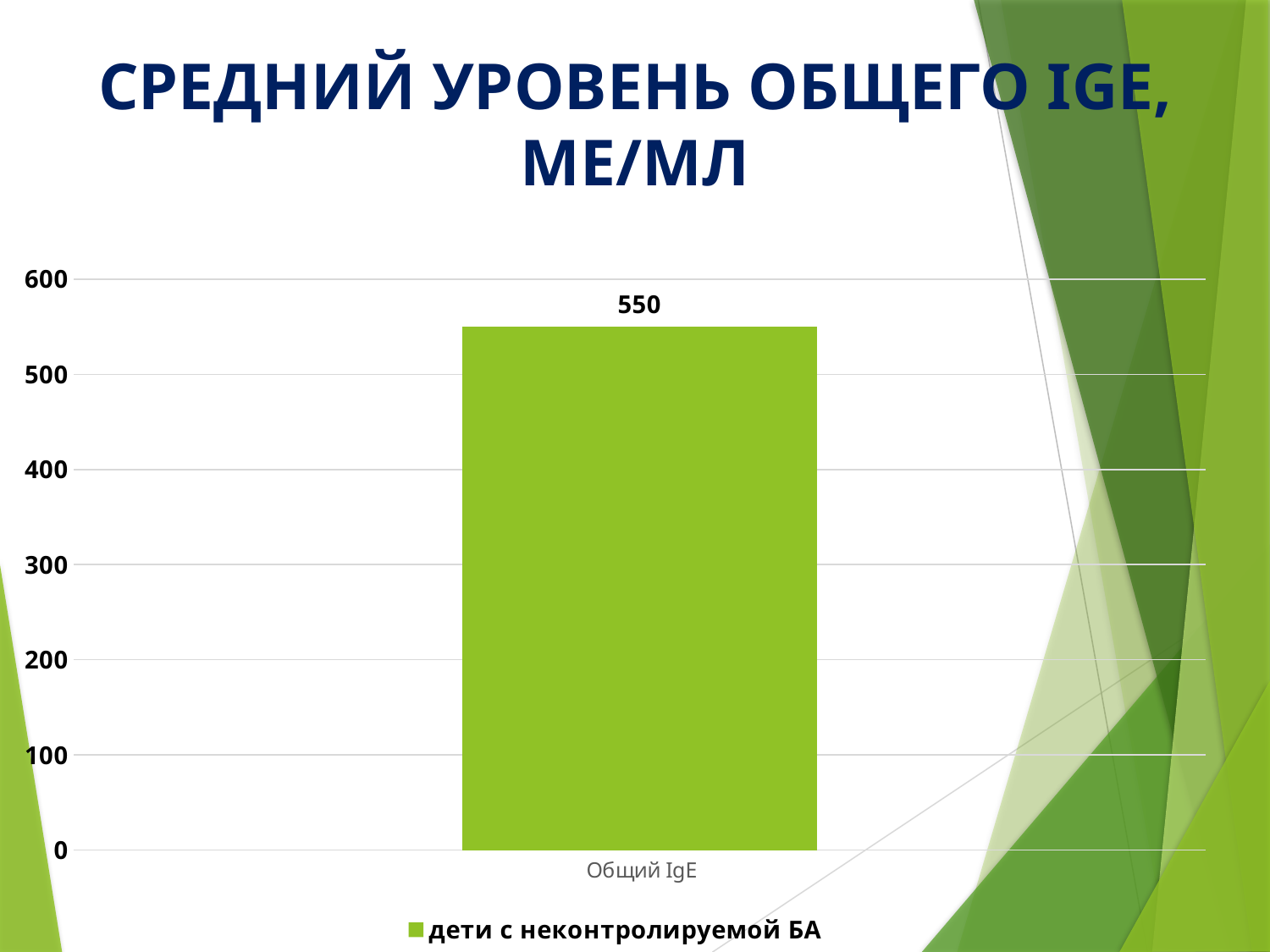
Is the value for Общий IgE greater or less than 600? less How many bars are plotted in the chart? 1 What kind of chart is shown on the slide? bar chart Is the value for Общий IgE greater or less than 500? greater What is the category label on the x axis? Общий IgE What is the value shown for Общий IgE? 550 What is the highest value shown on the vertical axis? 600 What is the title of the chart on the slide? СРЕДНИЙ УРОВЕНЬ ОБЩЕГО IGE, МЕ/МЛ How many series does the legend list? 1 What is the name of the series listed in the legend? дети с неконтролируемой БА